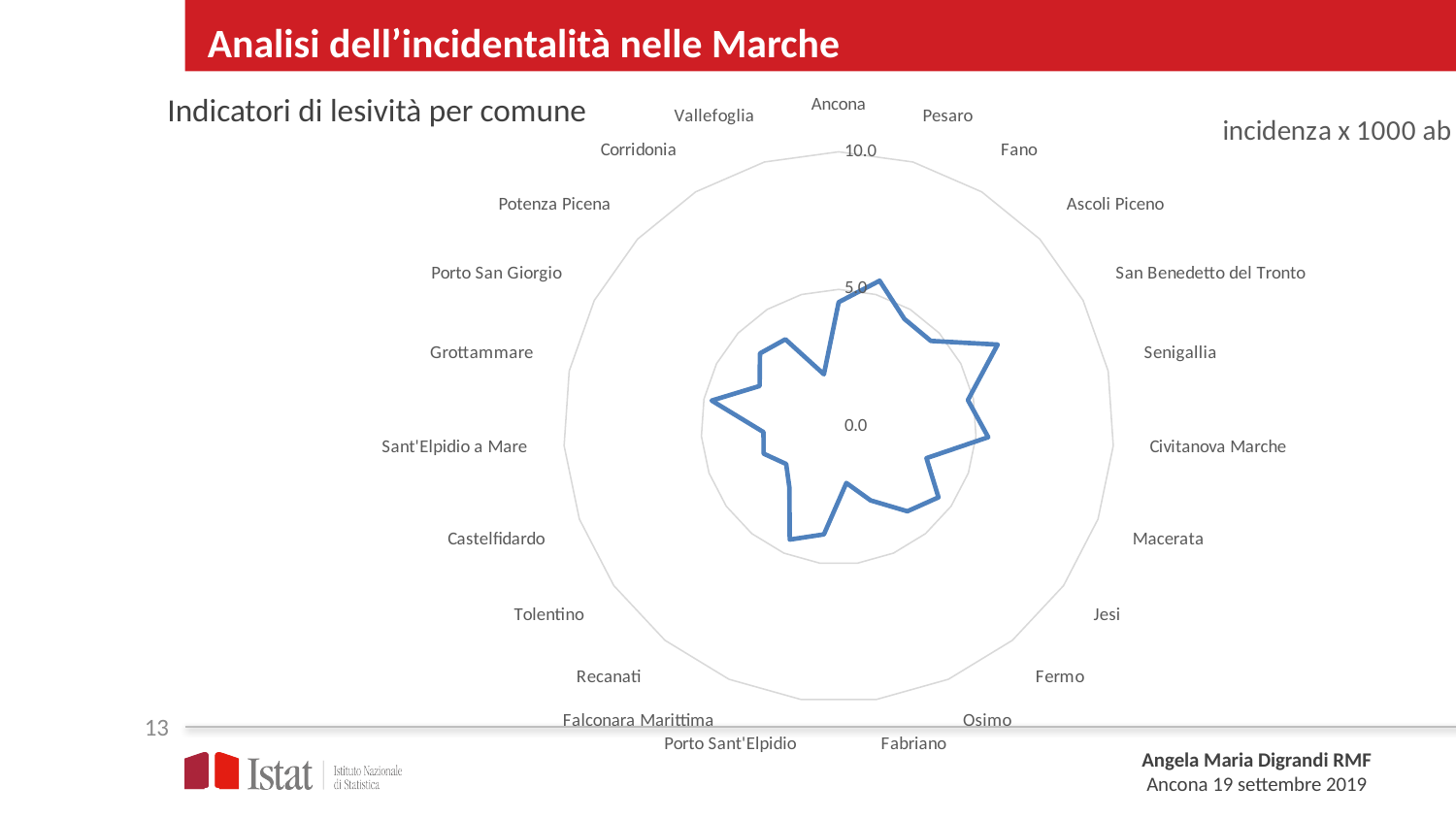
Is the value for Recanati greater or less than 5.0? less Is the value for Vallefoglia greater or less than 5.0? less What kind of chart is shown on the slide? Radar chart Is the value for Ancona greater or less than 10.0? less What is the highest value shown on the radial axis of the chart? 10.0 What is the title of the chart? incidenza x 1000 ab How many municipalities (categories) are plotted on the radar chart? 23 What unit is indicated for the values in the chart? incidenza x 1000 ab Which municipality has the highest value on the radar chart? San Benedetto del Tronto Which has the larger value, Senigallia or Osimo? Senigallia